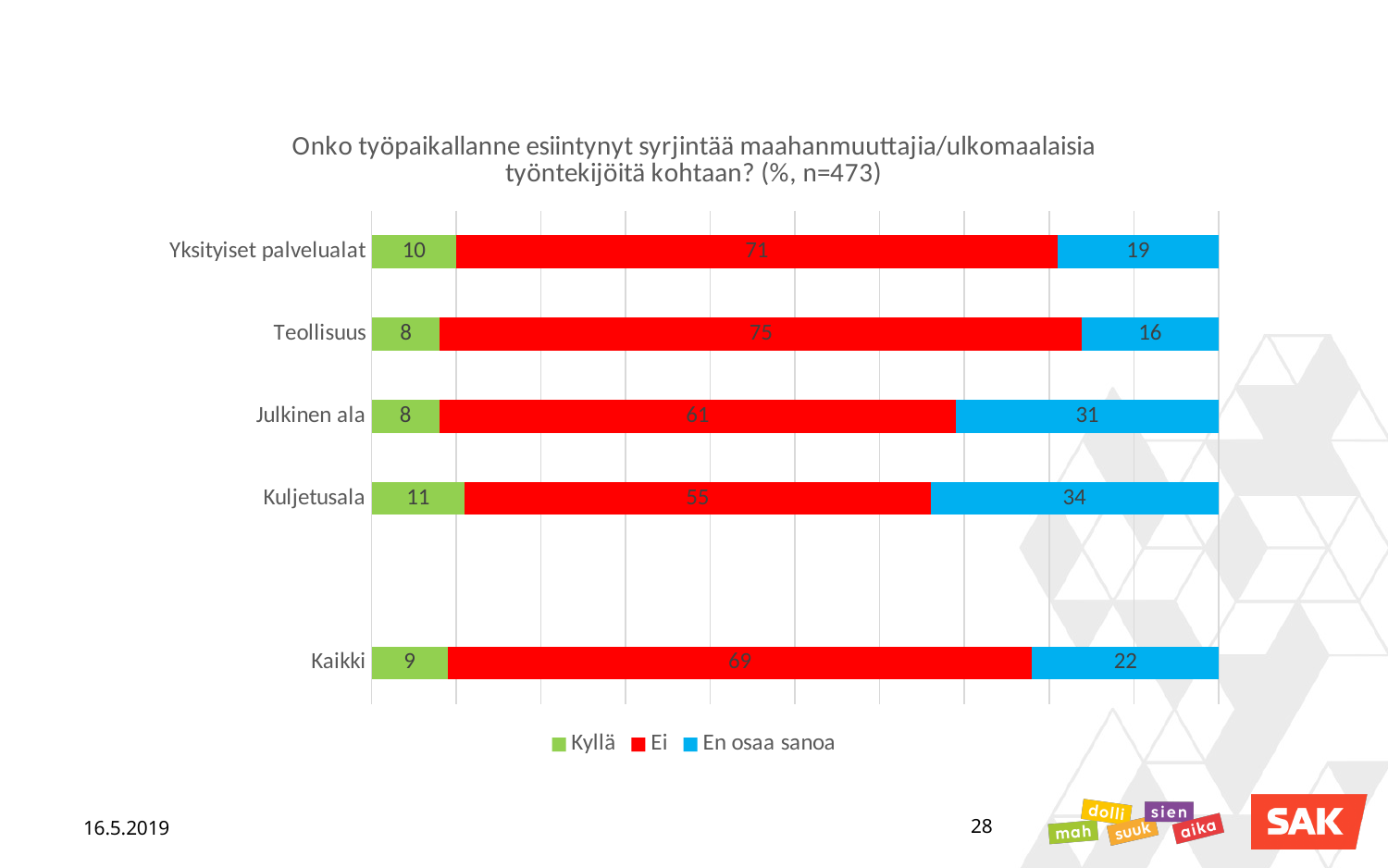
How many series does the legend list? 3 Which is larger: the "En osaa sanoa" value for Julkinen ala or for Yksityiset palvelualat? Julkinen ala Which category has the highest value for "Ei"? Teollisuus What is the value of "En osaa sanoa" for Kuljetusala? 34 What is the value of "Ei" for Teollisuus? 75 How many categories are shown on the y axis? 5 Which colour represents the "Kyllä" series? Green Which category has the lowest value for "En osaa sanoa"? Teollisuus What kind of chart is shown on the slide? Stacked bar chart What is the value of "Kyllä" for Kaikki? 9 What is the difference between the "Ei" values for Yksityiset palvelualat and Julkinen ala? 10 What is the total of the stacked bar for Kuljetusala? 100